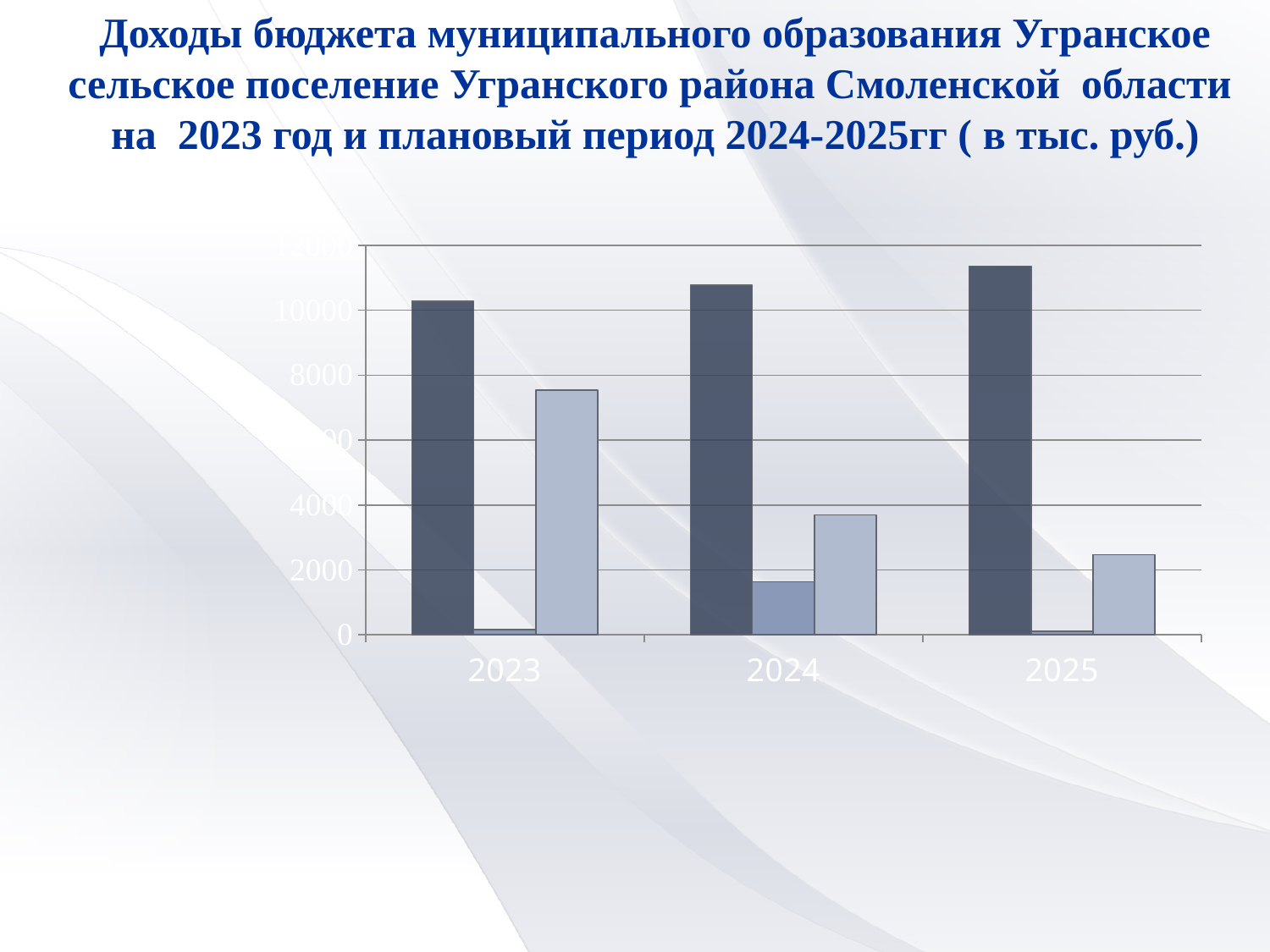
How many years (categories) are shown on the x axis of the chart? 3 Is the value of the dark bar for 2023 greater or less than 8000? greater What kind of chart is shown on the slide? bar chart In which year is the light-blue bar the shortest? 2025 Is the value of the tallest (dark) bar for 2025 greater or less than 10000? greater Do the values of the light-blue bars rise or fall from 2023 to 2025? fall How many bars are plotted for each year in the chart? 3 Is the value of the light-blue bar for 2024 greater or less than 4000? less In which year is the dark bar the tallest? 2025 Which is larger: the light-blue bar for 2023 or the light-blue bar for 2024? 2023